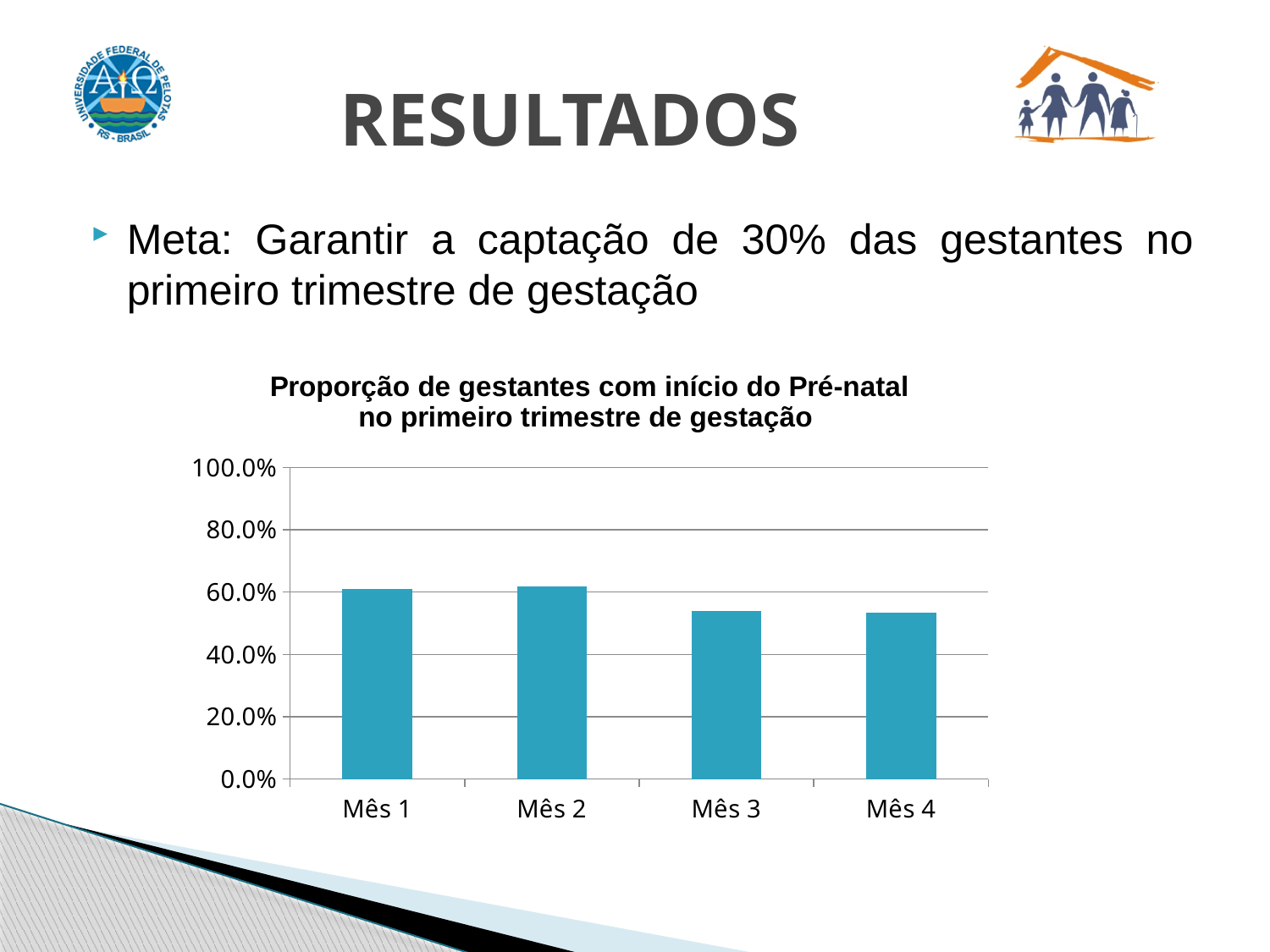
What is the highest value shown on the y axis of the chart? 100.0% From Mês 2 to Mês 4, do the values rise or fall? fall What kind of chart is shown on the slide? bar chart Which is larger, the value for Mês 1 or the value for Mês 4? Mês 1 What is the title of the chart? Proporção de gestantes com início do Pré-natal no primeiro trimestre de gestação Is the value for Mês 1 greater or less than 40.0%? greater How many categories (months) are shown on the x axis of the chart? 4 Is the value for Mês 4 greater or less than 80.0%? less Which is larger, the value for Mês 2 or the value for Mês 3? Mês 2 Is the value for Mês 4 greater or less than 40.0%? greater